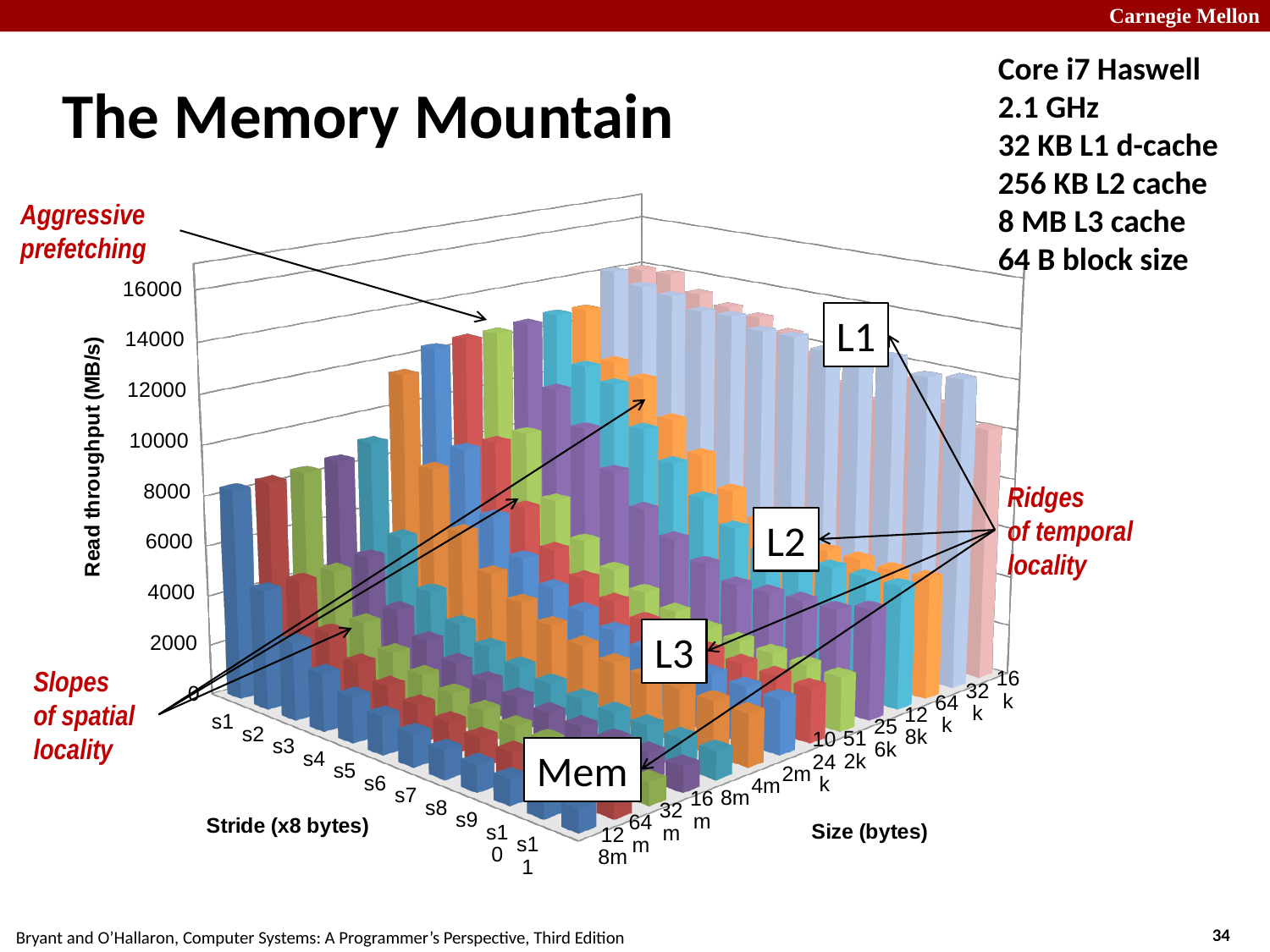
Is the read throughput for stride s1 at size 128m greater or less than 4000? greater How many stride categories (s1 through s11) are plotted along the stride axis? 11 What kind of chart is shown on the slide? 3D bar chart Which stride has the higher read throughput at size 128m, s1 or s11? s1 What is the label of the size axis of the chart? Size (bytes) Is the read throughput for stride s11 at size 128m greater or less than 2000? less What is the highest tick value shown on the vertical axis? 16000 Which size has the higher read throughput at stride s1, 16k or 128m? 16k What is the label of the vertical axis of the chart? Read throughput (MB/s) For size 128m, does read throughput rise or fall as the stride increases from s1 to s11? fall